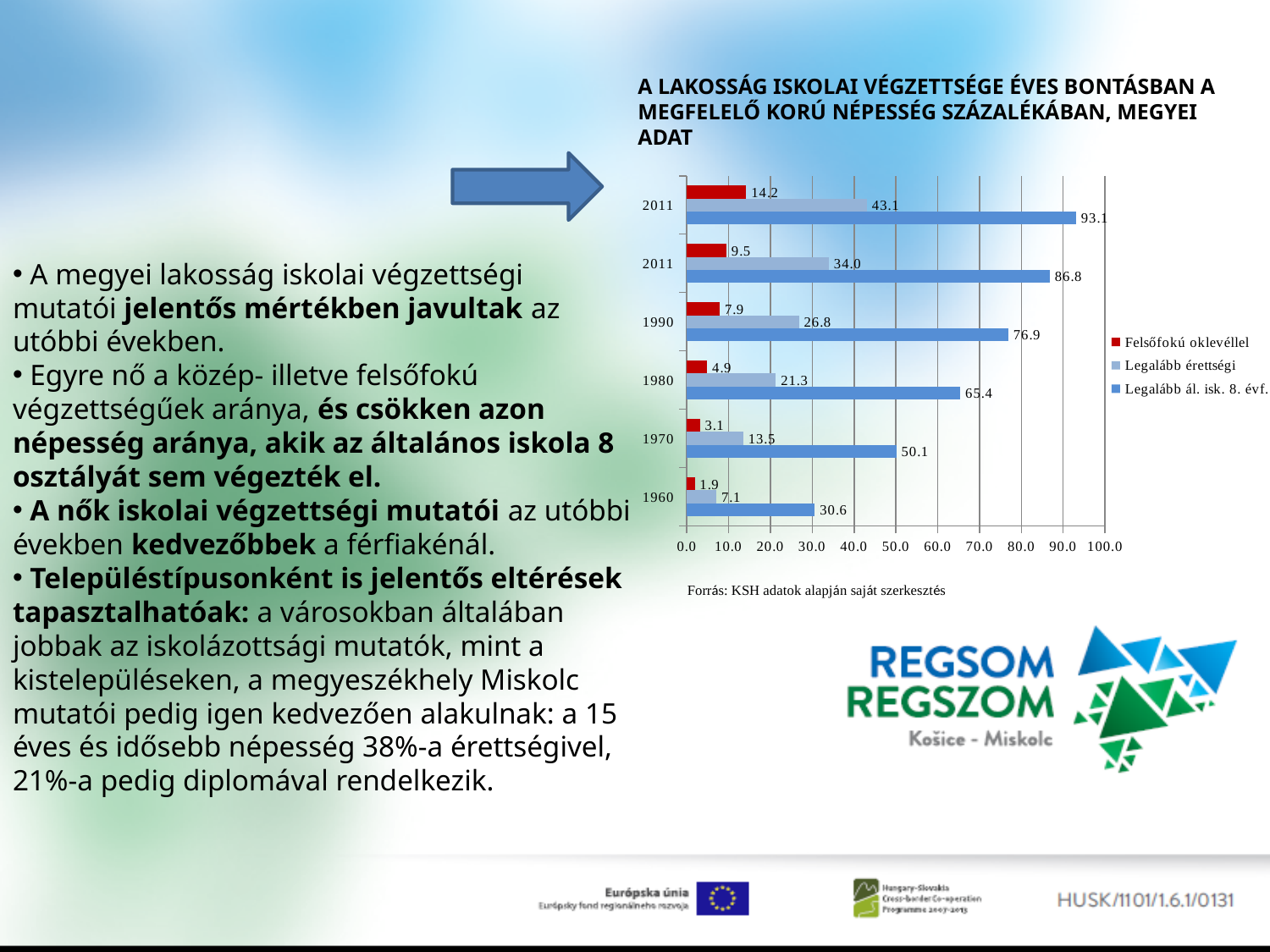
What is the value for 'Legalább ál. isk. 8. évf.' in 1990? 76.9 Which series is shown in red in the chart? Felsőfokú oklevéllel How many series does the chart legend list? 3 How many year categories are shown on the vertical axis of the chart? 6 What type of chart is shown on the slide? bar chart What is the value for 'Felsőfokú oklevéllel' in 1960? 1.9 Do the 'Felsőfokú oklevéllel' values rise or fall when moving from 1960 up to the topmost 2011 group? rise Which year has the lowest value for 'Legalább ál. isk. 8. évf.'? 1960 What is the value for 'Legalább érettségi' in 1970? 13.5 What is the difference between the 'Legalább ál. isk. 8. évf.' values for 1990 and 1980? 11.5 Which is larger: the 'Legalább érettségi' value in 1990 or the 'Felsőfokú oklevéllel' value in the topmost 2011 bar group? Legalább érettségi in 1990 What is the value for 'Legalább érettségi' in 1980? 21.3